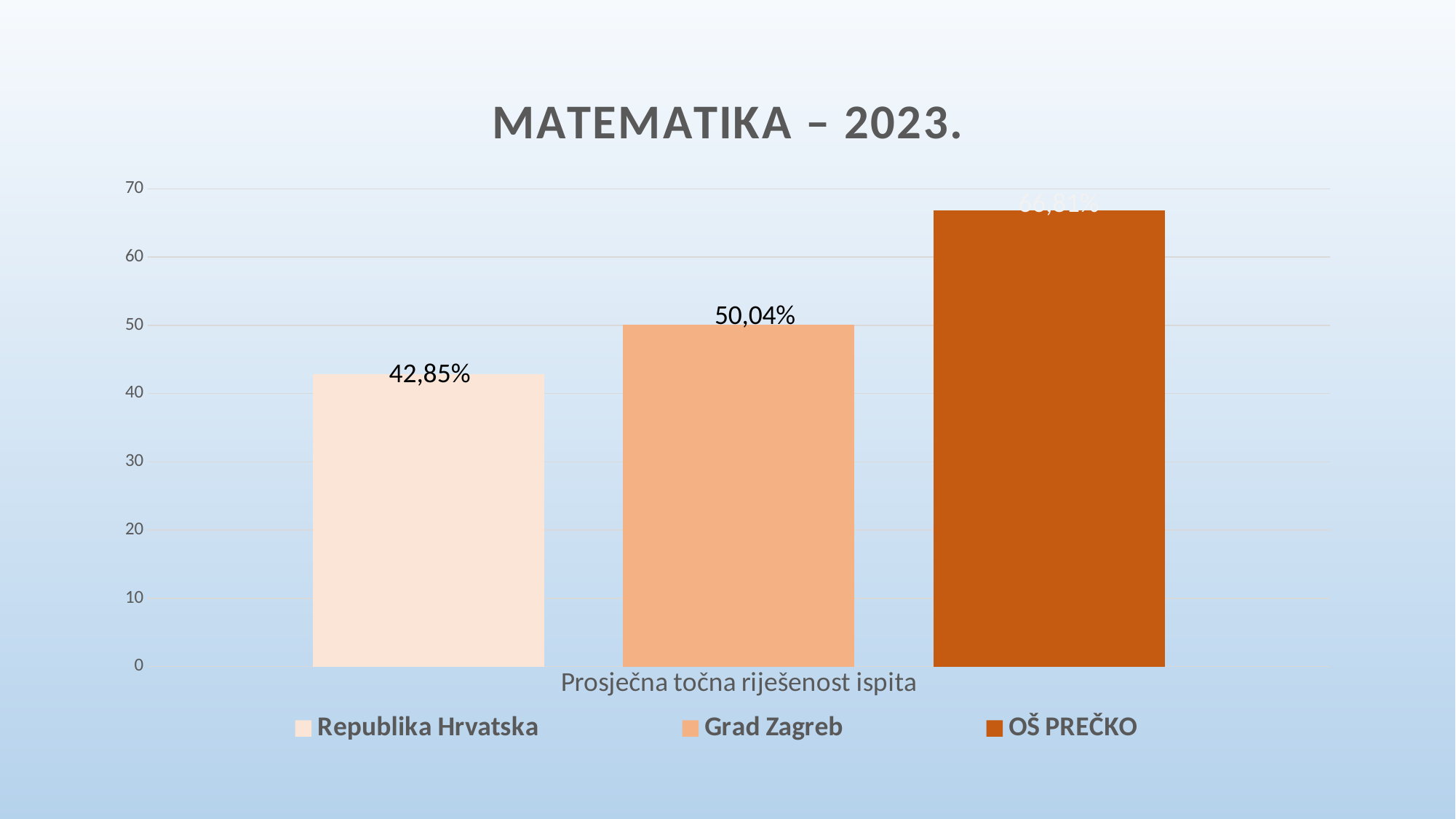
How many series does the legend list? 3 Which is larger, the value for Grad Zagreb or the value for Republika Hrvatska? Grad Zagreb What is the difference between the values for Grad Zagreb and Republika Hrvatska? 7,19% Is the value for OŠ PREČKO greater or less than 60? greater Which series has the highest bar? OŠ PREČKO Which series has the lowest bar? Republika Hrvatska What is the value for Grad Zagreb? 50,04% What is the value for Republika Hrvatska? 42,85% Is the value for OŠ PREČKO greater or less than 70? less What kind of chart is shown on the slide? bar chart What is the title of the chart? MATEMATIKA – 2023. Is the value for Republika Hrvatska greater or less than 40? greater